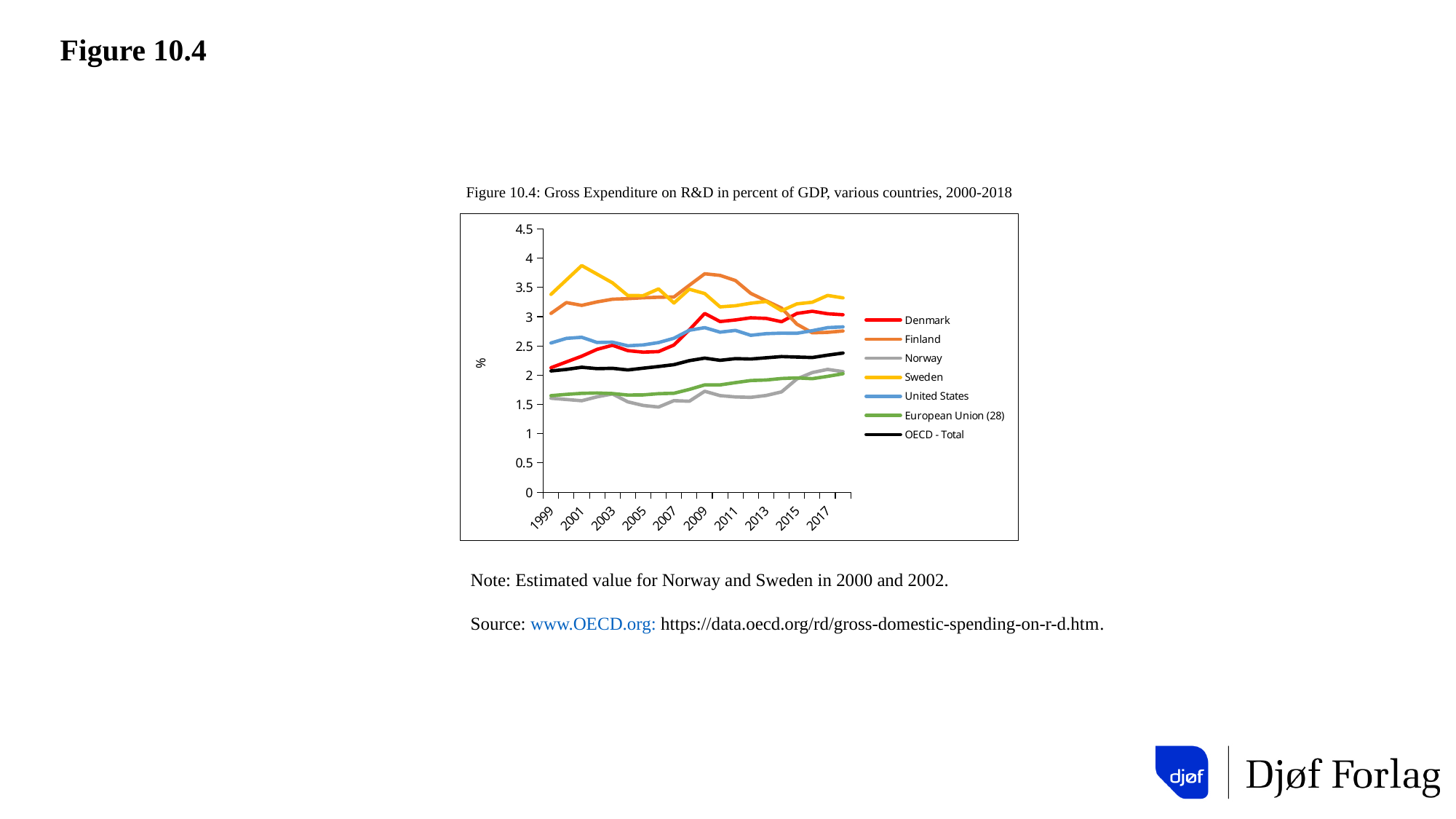
Which series has the lowest value in 2013? Norway Is the value for OECD - Total in 2017 greater or less than 2? greater Does the value for Finland rise or fall from 2009 to 2017? fall Is the value for Denmark in 1999 greater or less than 2.5? less In 2017, which is larger: the value for Sweden or the value for Finland? Sweden Which series has the lowest value in 2005? Norway Is the value for Sweden in 2001 greater or less than 3.5? greater What kind of chart is shown on the slide? line chart Which series has the highest value in 2009? Finland Which series has the highest value in 2001? Sweden What is the label on the y axis? % How many series does the legend list? 7